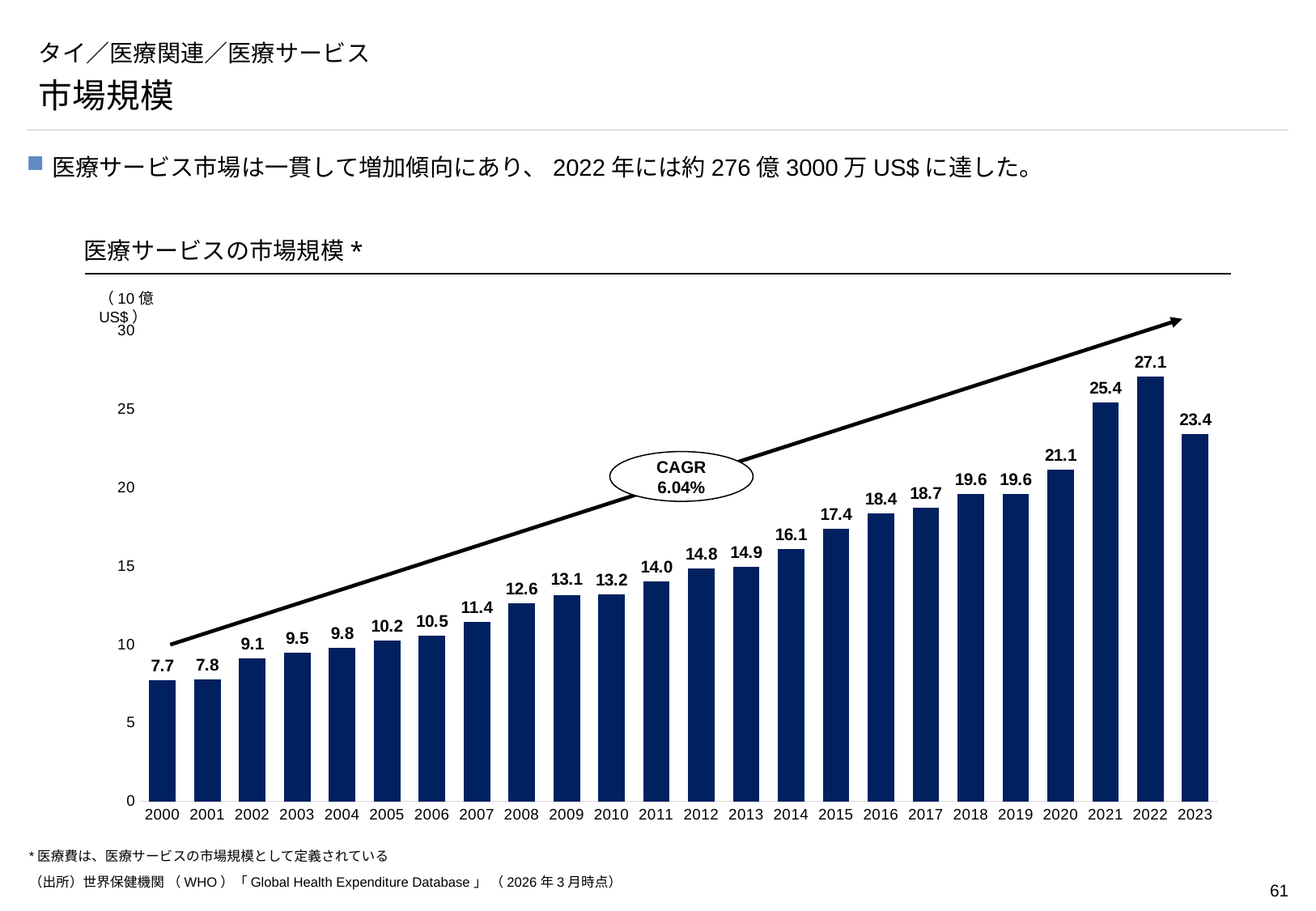
What is the value for 2015 in the chart? 17.4 What is the difference between the values for 2022 and 2021? 1.7 What is the difference between the values for 2022 and 2023? 3.7 What CAGR value is shown in the oval on the chart? 6.04% What is the value for 2000 in the chart? 7.7 What kind of chart is shown on the slide? bar chart Is the value for 2020 greater or less than 20? greater How many years are shown on the x axis of the chart? 24 Which is larger, the value for 2021 or the value for 2023? 2021 What is the value for 2022 in the chart? 27.1 Which year has the lowest value in the chart? 2000 Which year has the highest value in the chart? 2022